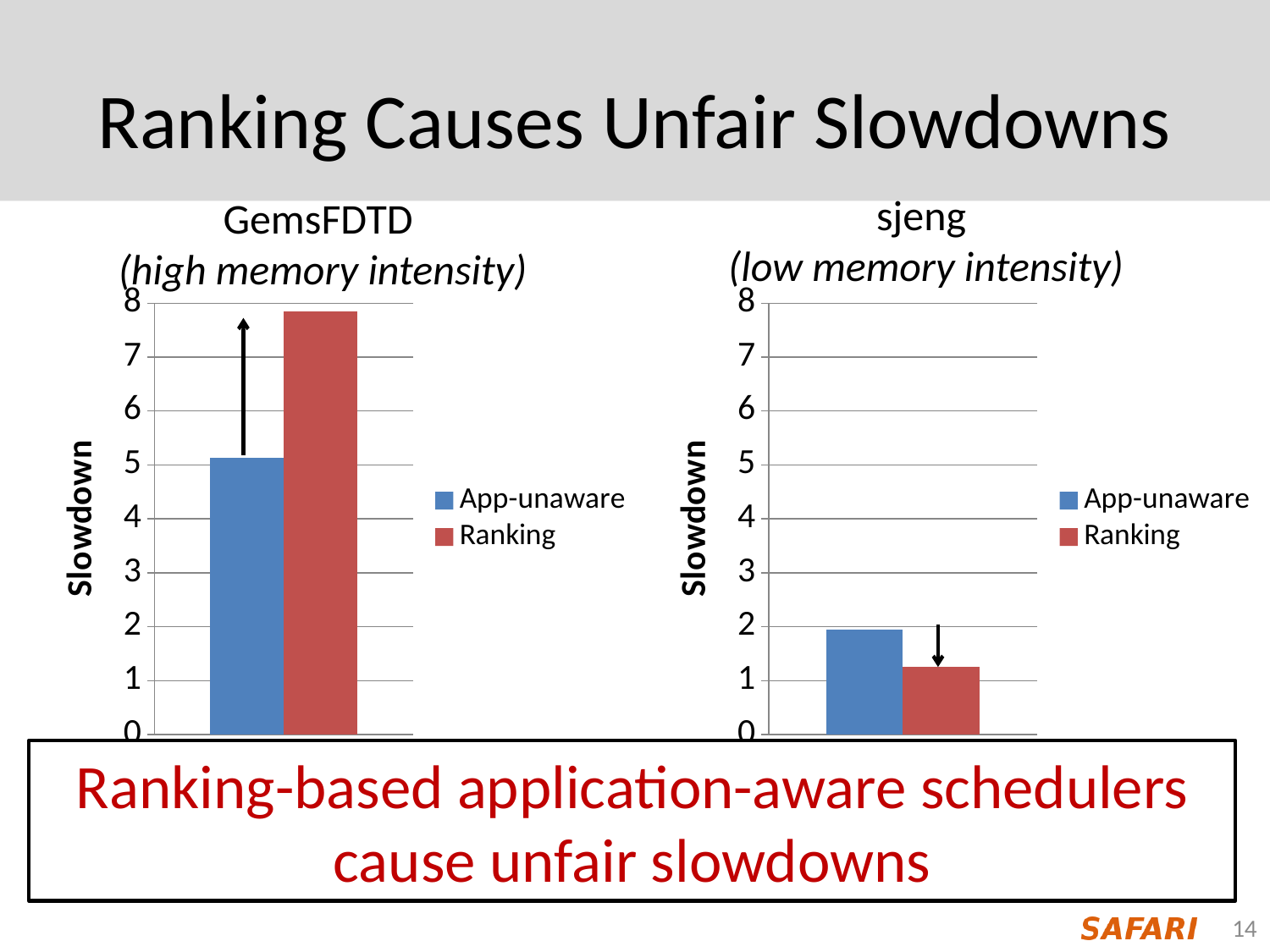
In the sjeng chart, is the value for App-unaware greater or less than 3? less In the GemsFDTD chart, is the value for App-unaware greater or less than 4? greater In the sjeng chart, is the value for Ranking greater or less than 2? less In the GemsFDTD chart, which colour represents the Ranking series? red In the sjeng chart, which series has the larger slowdown, App-unaware or Ranking? App-unaware How many bar charts are shown on the slide? 2 What is the y-axis title of the sjeng chart? Slowdown How many series does the legend of the sjeng chart list? 2 What kind of chart is the GemsFDTD chart? bar chart In the GemsFDTD chart, which series has the larger slowdown, App-unaware or Ranking? Ranking